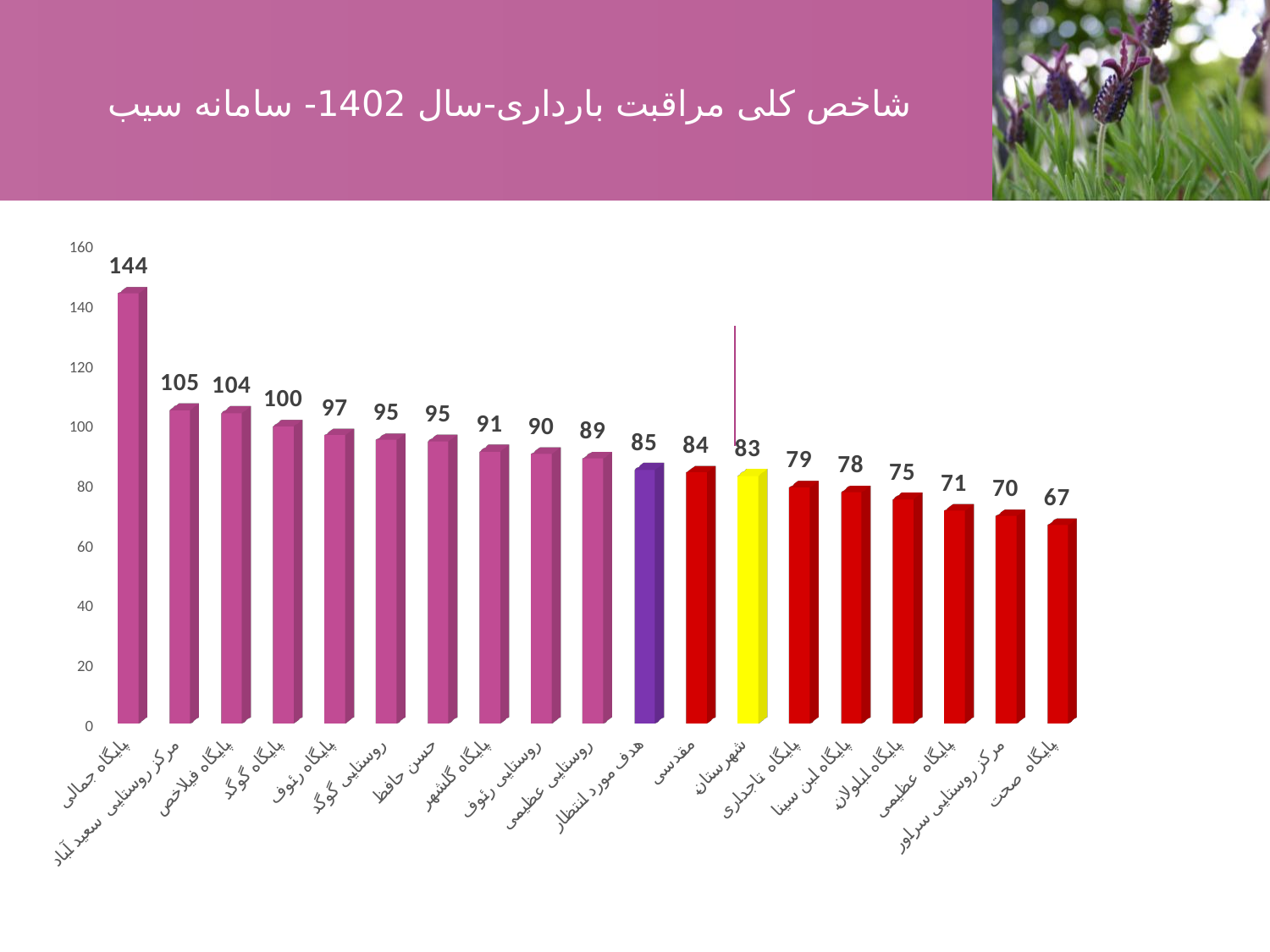
How many bars are plotted in the chart? 19 What is the value for پایگاه جمالی? 144 What type of chart is shown on the slide? bar chart What is the difference between the values for پایگاه جمالی and پایگاه صحت? 77 Do the values generally rise or fall from left to right along the x axis? fall What is the value for هدف مورد انتظار? 85 Which category has the lowest value? پایگاه صحت What is the title of the slide? شاخص کلی مراقبت بارداری-سال 1402- سامانه سیب What is the value for شهرستان? 83 Which category has the highest value? پایگاه جمالی What is the value for پایگاه صحت? 67 Which is larger, the value for پایگاه گوگد or the value for پایگاه تاجداری? پایگاه گوگد